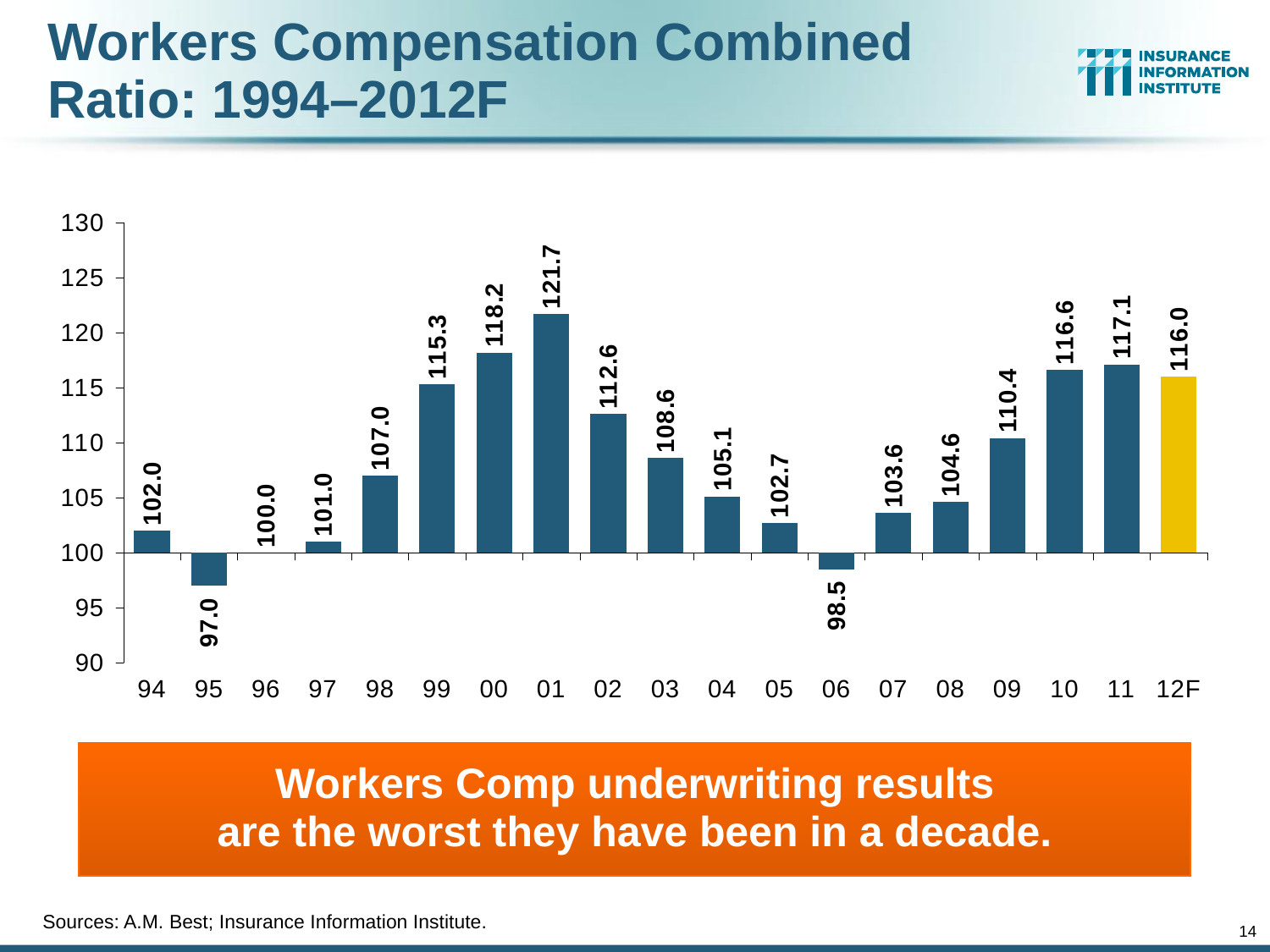
What is the combined ratio for 2006? 98.5 What is the workers compensation combined ratio for 2001? 121.7 How many years (bars) are shown on the x axis? 19 What kind of chart is shown on the slide? Bar chart Which year has the highest combined ratio? 01 Which bar is shown in a different colour (yellow) from the others? 12F What is the difference between the combined ratio in 2001 and in 1995? 24.7 Which is larger, the combined ratio for 1999 or for 2002? 1999 What is the combined ratio shown for 12F? 116.0 Do the combined ratio values rise or fall from 2006 to 2011? Rise Which year has the lowest combined ratio? 95 What is the difference between the combined ratio in 2011 and in 2010? 0.5